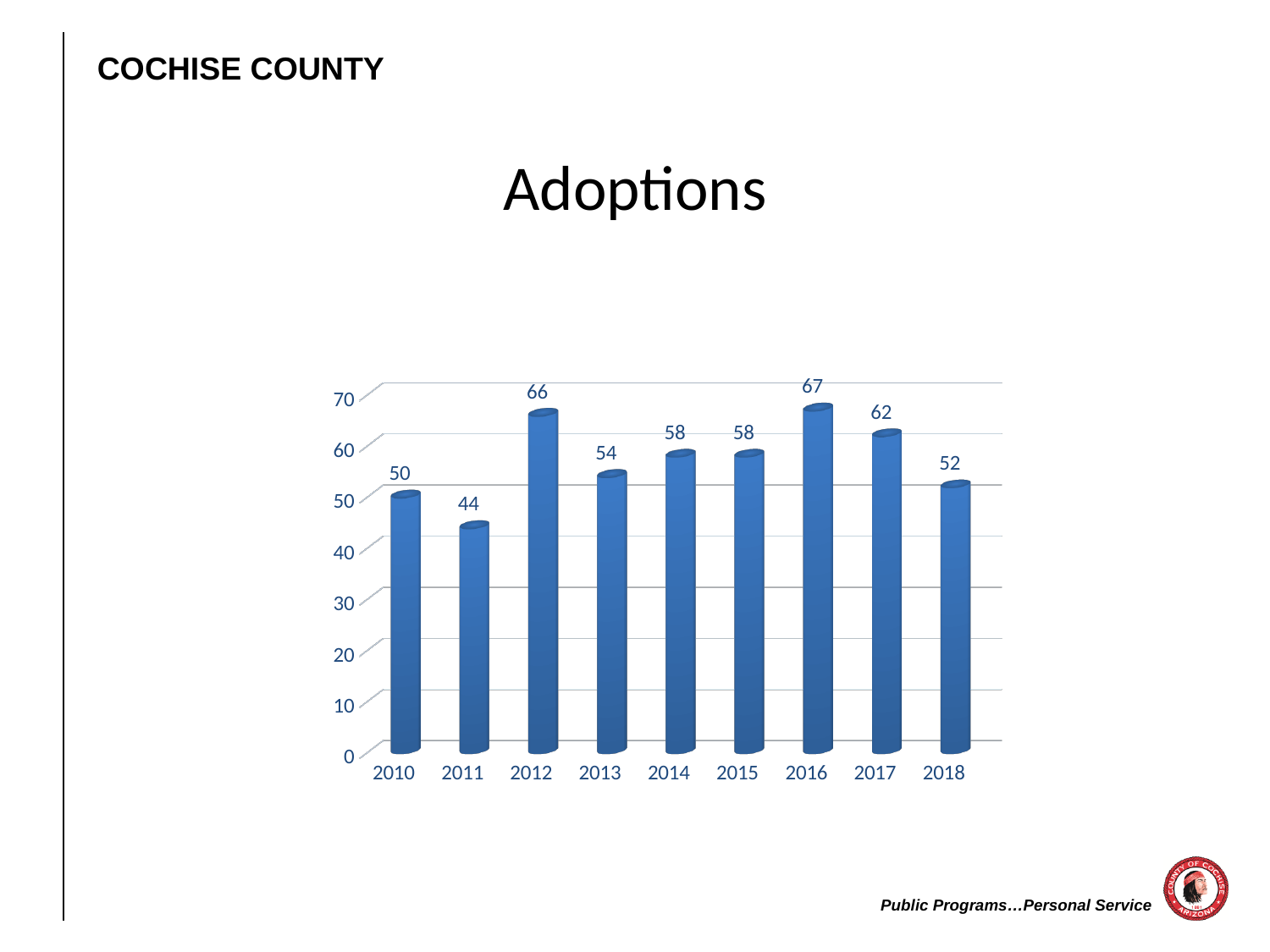
Which year has the highest value? 2016 Which is larger, the value for 2010 or the value for 2013? 2013 Which year has the lowest value? 2011 How many years are shown on the x axis? 9 What is the value for 2011? 44 What kind of chart is this? bar chart What is the difference between the values for 2016 and 2011? 23 What is the difference between the values for 2017 and 2018? 10 What is the value for 2018? 52 Is the value for 2017 greater or less than 60? greater What is the value for 2012? 66 What is the title of the chart? Adoptions